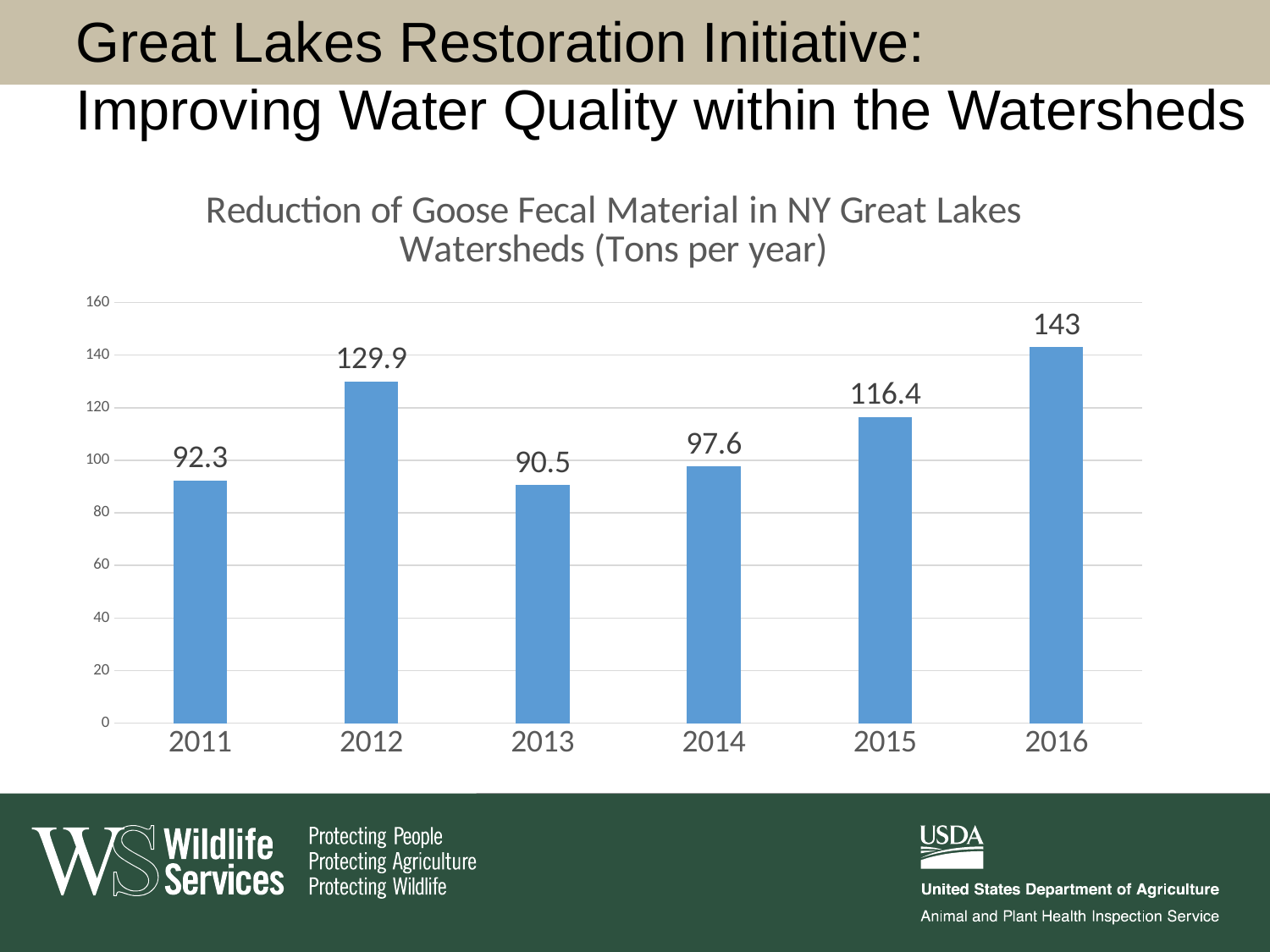
Which year has the lowest value? 2013 What is the difference between the values for 2016 and 2011? 50.7 What is the value for 2012? 129.9 Is the value for 2014 greater or less than 100? less What is the value for 2015? 116.4 What is the title of the chart? Reduction of Goose Fecal Material in NY Great Lakes Watersheds (Tons per year) Which is larger, the value for 2012 or the value for 2015? 2012 Does the value rise or fall from 2013 to 2016? rise How many years are shown on the x axis? 6 What is the value for 2013? 90.5 Which year has the highest value? 2016 What kind of chart is shown on the slide? bar chart